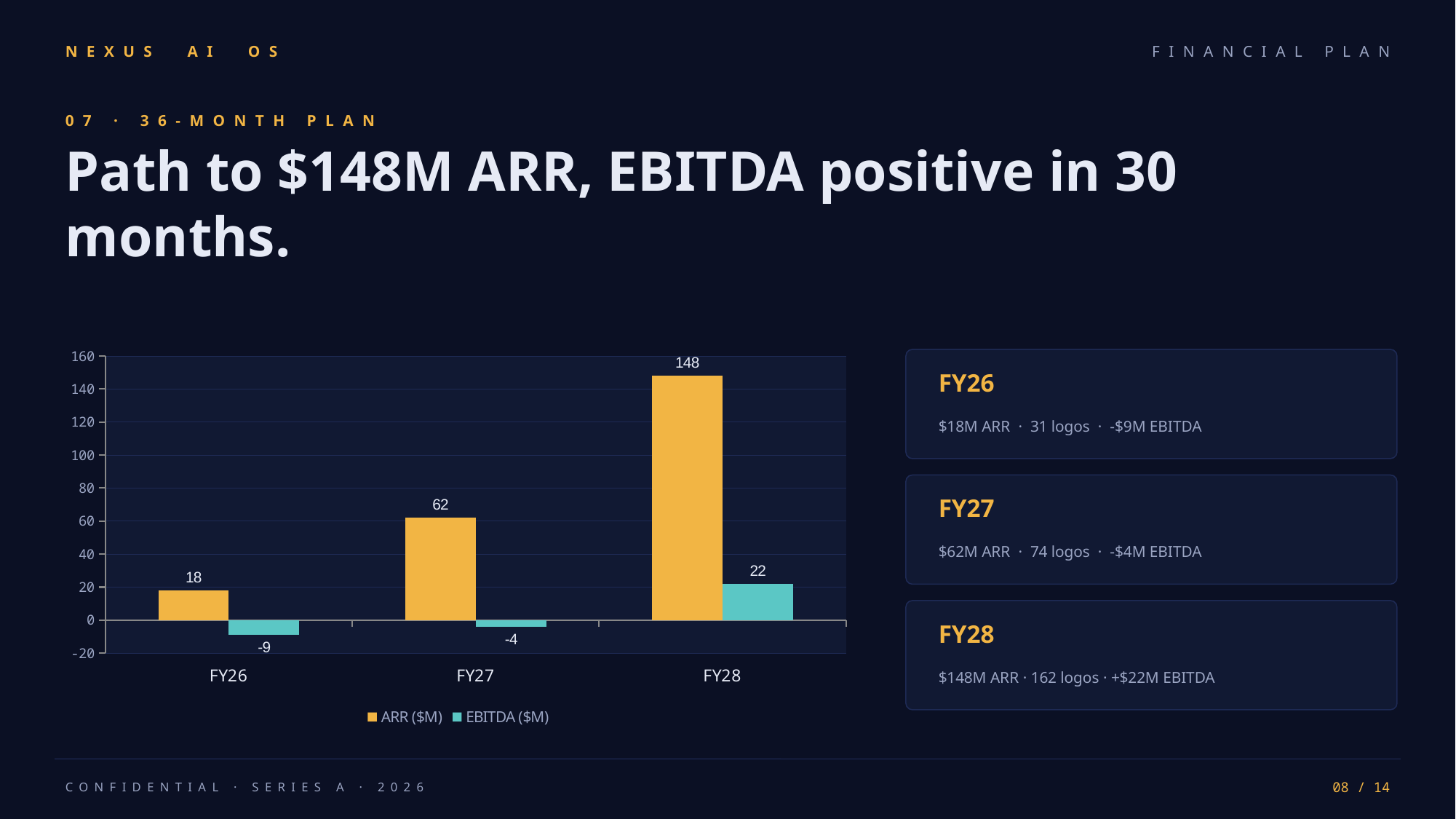
What kind of chart is shown on the slide? bar chart Which fiscal year has the lowest EBITDA ($M)? FY26 Does the EBITDA ($M) series rise or fall from FY26 to FY28? rise What is the difference between the ARR ($M) for FY28 and FY27? 86 What is the EBITDA ($M) value for FY28? 22 Which is larger, the ARR ($M) for FY26 or the ARR ($M) for FY27? FY27 How many fiscal years are shown on the x axis? 3 What is the ARR ($M) value for FY27? 62 Which fiscal year has the highest ARR ($M)? FY28 Is the ARR ($M) value for FY28 greater or less than 140? greater How many series does the legend list? 2 What is the EBITDA ($M) value for FY26? -9